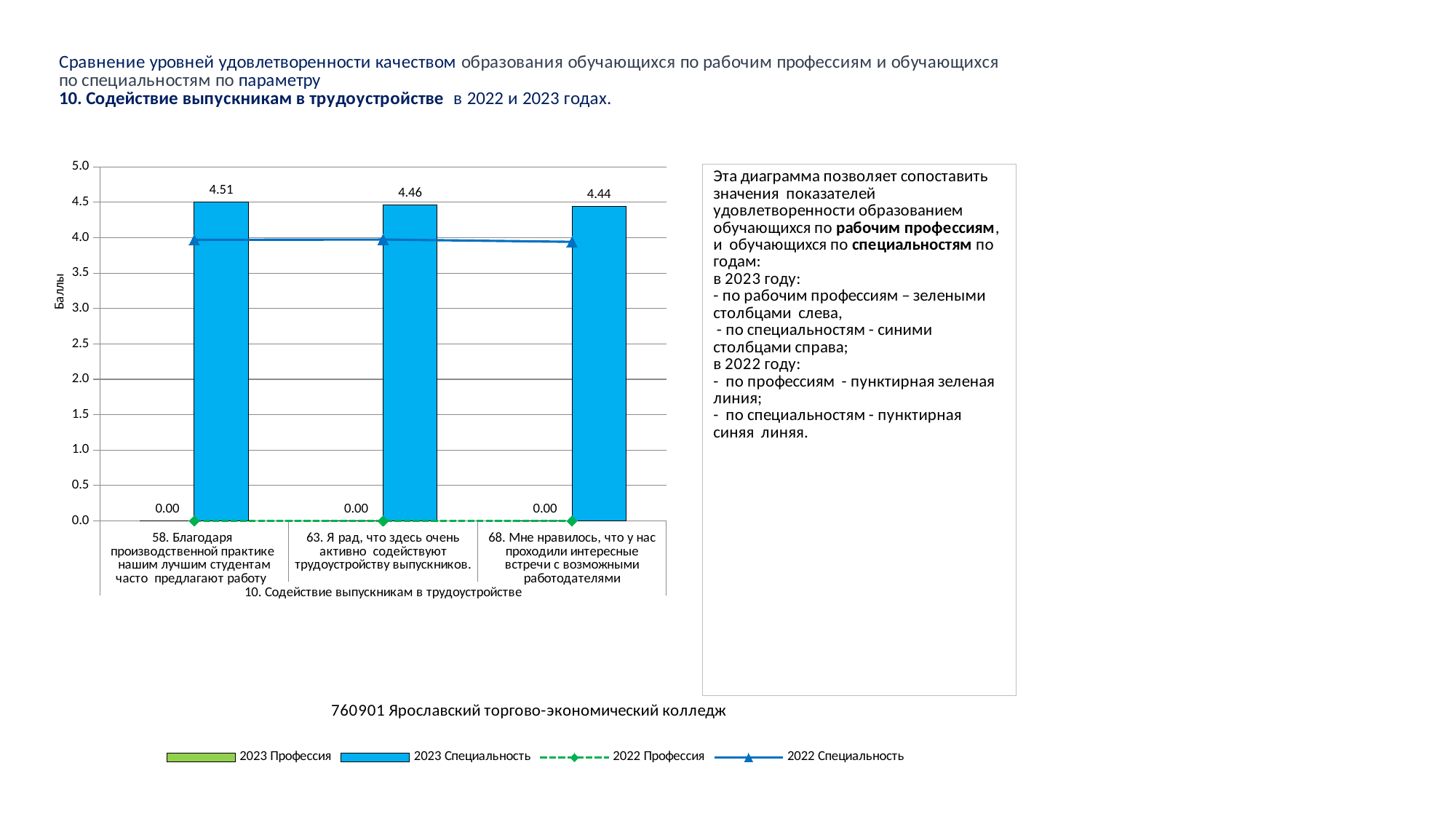
Is the 2022 Специальность value for category 63 greater or less than 3.5? greater What is the difference between the 2023 Специальность values for category 58 and category 68? 0.07 Which category has the highest 2023 Специальность value? 58. Благодаря производственной практике нашим лучшим студентам часто предлагают работу What value is labelled for the 2023 Профессия series in category 58? 0.00 What is the value of the 2023 Специальность bar for category 63 (Я рад, что здесь очень активно содействуют трудоустройству выпускников)? 4.46 Do the 2023 Специальность values rise or fall from left to right across the categories? fall What is the label of the y axis? Баллы How many series does the legend list? 4 What is the value of the 2023 Специальность bar for category 58 (Благодаря производственной практике нашим лучшим студентам часто предлагают работу)? 4.51 Which category has the lowest 2023 Специальность value? 68. Мне нравилось, что у нас проходили интересные встречи с возможными работодателями How many categories are shown on the x axis? 3 What is the value of the 2023 Специальность bar for category 68 (Мне нравилось, что у нас проходили интересные встречи с возможными работодателями)? 4.44